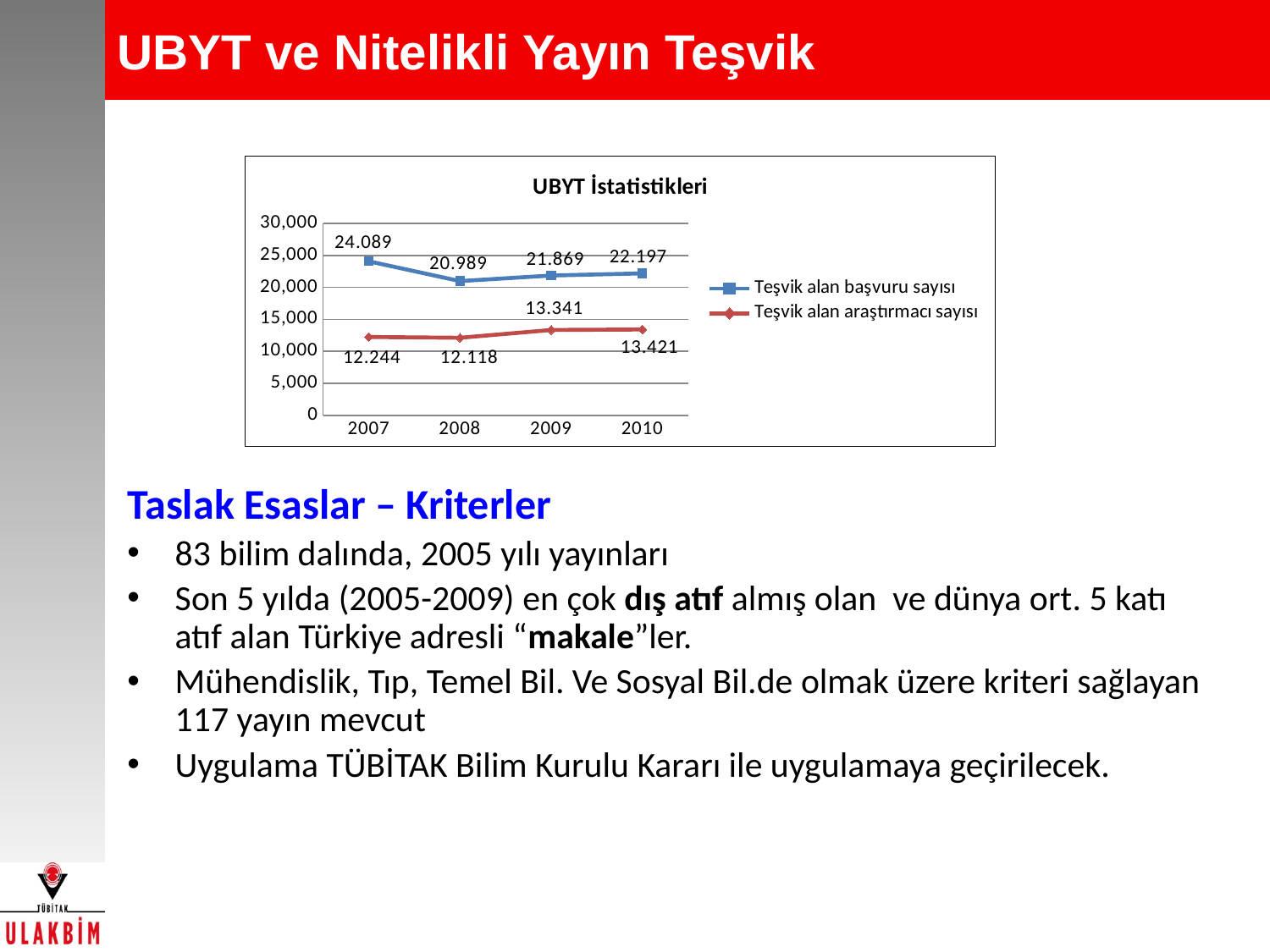
Does 'Teşvik alan başvuru sayısı' rise or fall from 2008 to 2010? rise In which year is 'Teşvik alan araştırmacı sayısı' lowest? 2008 How many series does the chart legend list? 2 What is the value of 'Teşvik alan araştırmacı sayısı' in 2009? 13.341 What is the value of 'Teşvik alan başvuru sayısı' in 2007? 24.089 In which year is 'Teşvik alan başvuru sayısı' highest? 2007 How many years are shown on the x axis of the chart? 4 What type of chart is shown on the slide? line chart Which is larger in 2010: 'Teşvik alan başvuru sayısı' or 'Teşvik alan araştırmacı sayısı'? Teşvik alan başvuru sayısı What is the title of the chart? UBYT İstatistikleri What is the difference between 'Teşvik alan başvuru sayısı' in 2007 and in 2008? 3.100 In which year is 'Teşvik alan başvuru sayısı' lowest? 2008